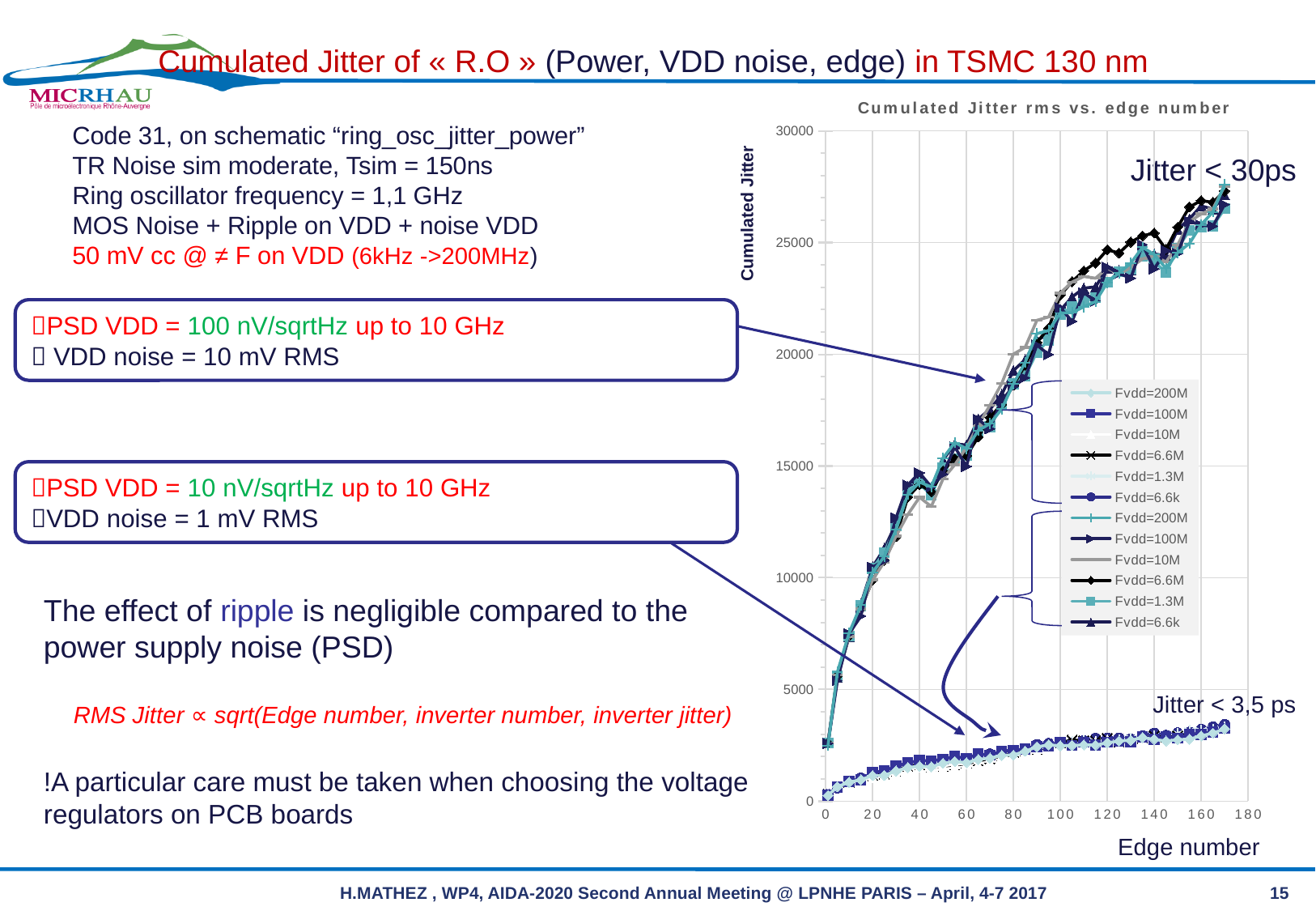
Which group of curves reaches higher values at edge number 160, the upper group annotated 'Jitter < 30ps' or the lower group annotated 'Jitter < 3,5 ps'? the upper group (Jitter < 30ps) What is the label of the x axis of the chart? Edge number What kind of chart is shown on the slide? line chart Do the cumulated jitter values rise or fall as the edge number increases? rise What is the highest tick value shown on the x axis of the chart? 180 How many series does the chart legend list? 12 Is the value of the lower group of curves at edge number 160 greater or less than 5000? less Is the value of the upper group of curves at edge number 40 greater or less than 10000? greater Is the value of the upper group of curves at edge number 160 greater or less than 25000? greater What is the title of the chart? Cumulated Jitter rms vs. edge number What is the highest tick value shown on the y axis of the chart? 30000